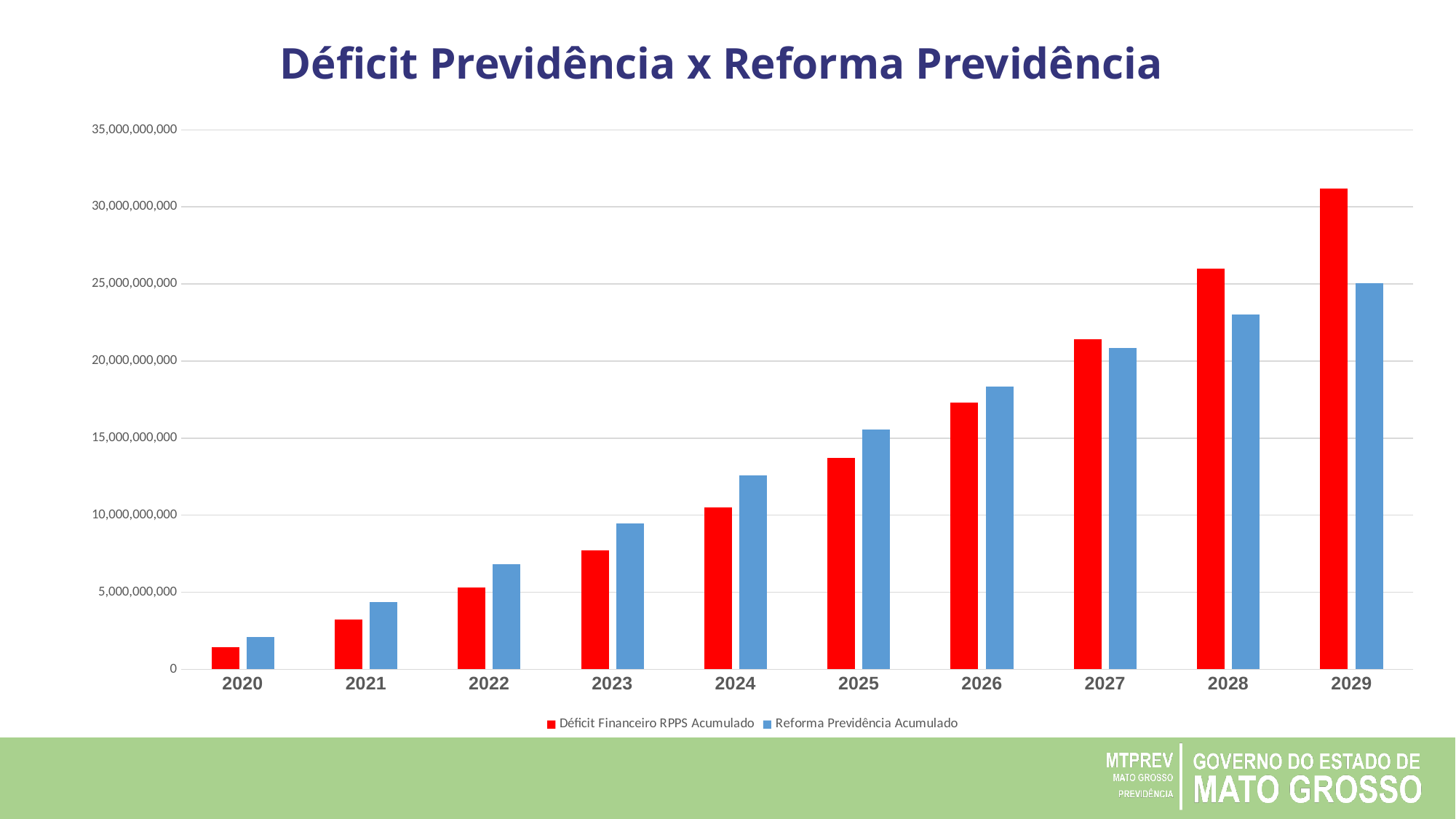
How many series does the legend list? 2 Do the Déficit Financeiro RPPS Acumulado values rise or fall from 2020 to 2029? rise In which year is the Déficit Financeiro RPPS Acumulado bar the highest? 2029 What kind of chart is shown on the slide? bar chart In which year is the Reforma Previdência Acumulado bar the lowest? 2020 Is the value for Reforma Previdência Acumulado in 2024 greater or less than 10,000,000,000? greater How many years are shown on the x axis? 10 Is the value for Reforma Previdência Acumulado in 2028 greater or less than 25,000,000,000? less In 2024, which series has the larger value: Déficit Financeiro RPPS Acumulado or Reforma Previdência Acumulado? Reforma Previdência Acumulado Is the value for Déficit Financeiro RPPS Acumulado in 2023 greater or less than 10,000,000,000? less In 2029, which series has the larger value: Déficit Financeiro RPPS Acumulado or Reforma Previdência Acumulado? Déficit Financeiro RPPS Acumulado